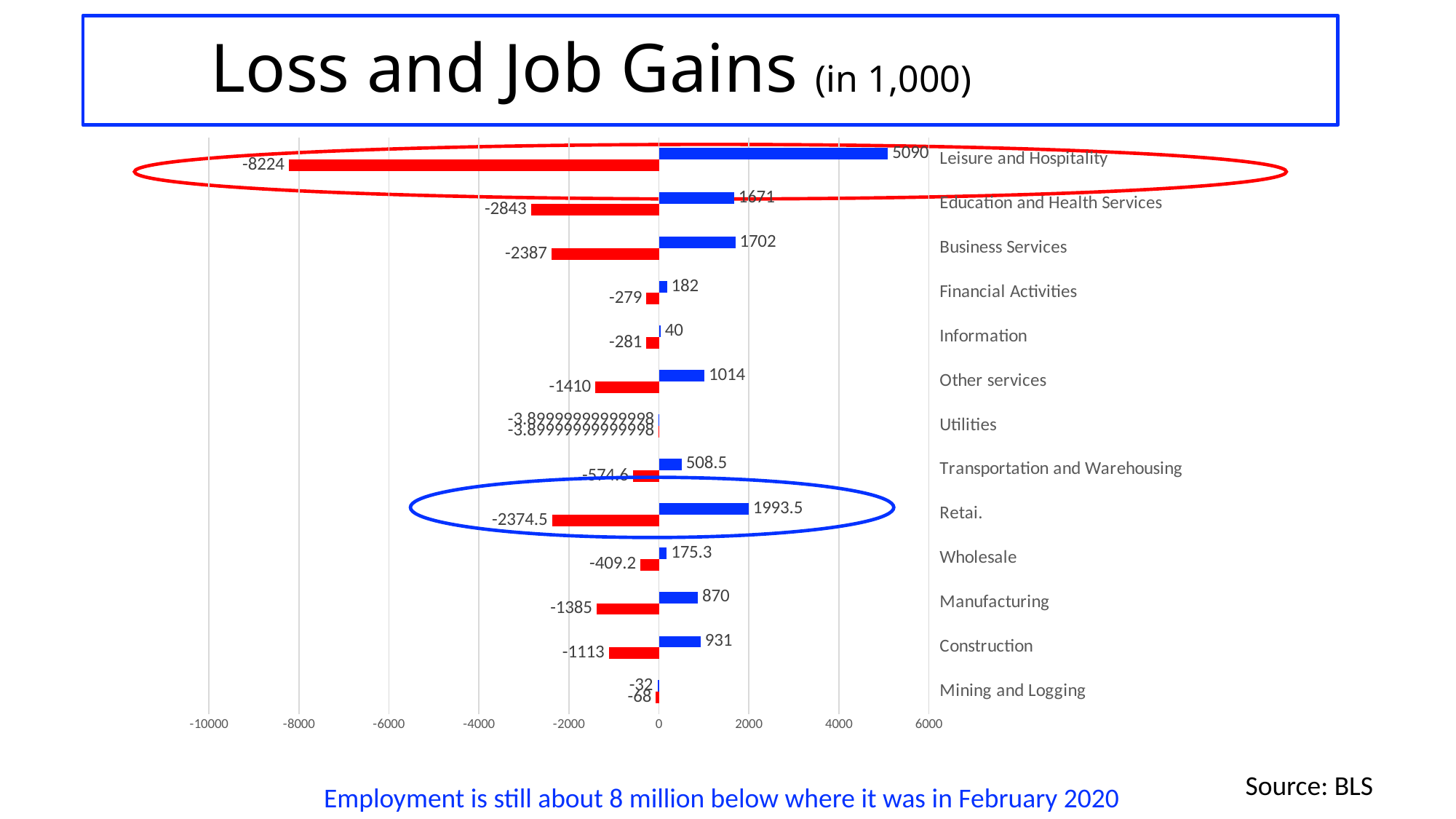
What is the job loss value shown for Manufacturing? -1385 What is the job gain value shown for Retail? 1993.5 What kind of chart is shown on the slide? bar chart Which category has the largest job gain (longest blue bar)? Leisure and Hospitality What is the job gain value shown for Wholesale? 175.3 Is the job gain value for Transportation and Warehousing greater or less than 1000? less Which category has the largest job loss (longest red bar)? Leisure and Hospitality How much larger is the job gain for Leisure and Hospitality than the job gain for Education and Health Services? 3419 What colour are the bars representing job losses? red Which has the larger job gain, Manufacturing or Construction? Construction What is the job loss value shown for Leisure and Hospitality? -8224 How many industry categories are shown on the chart? 13